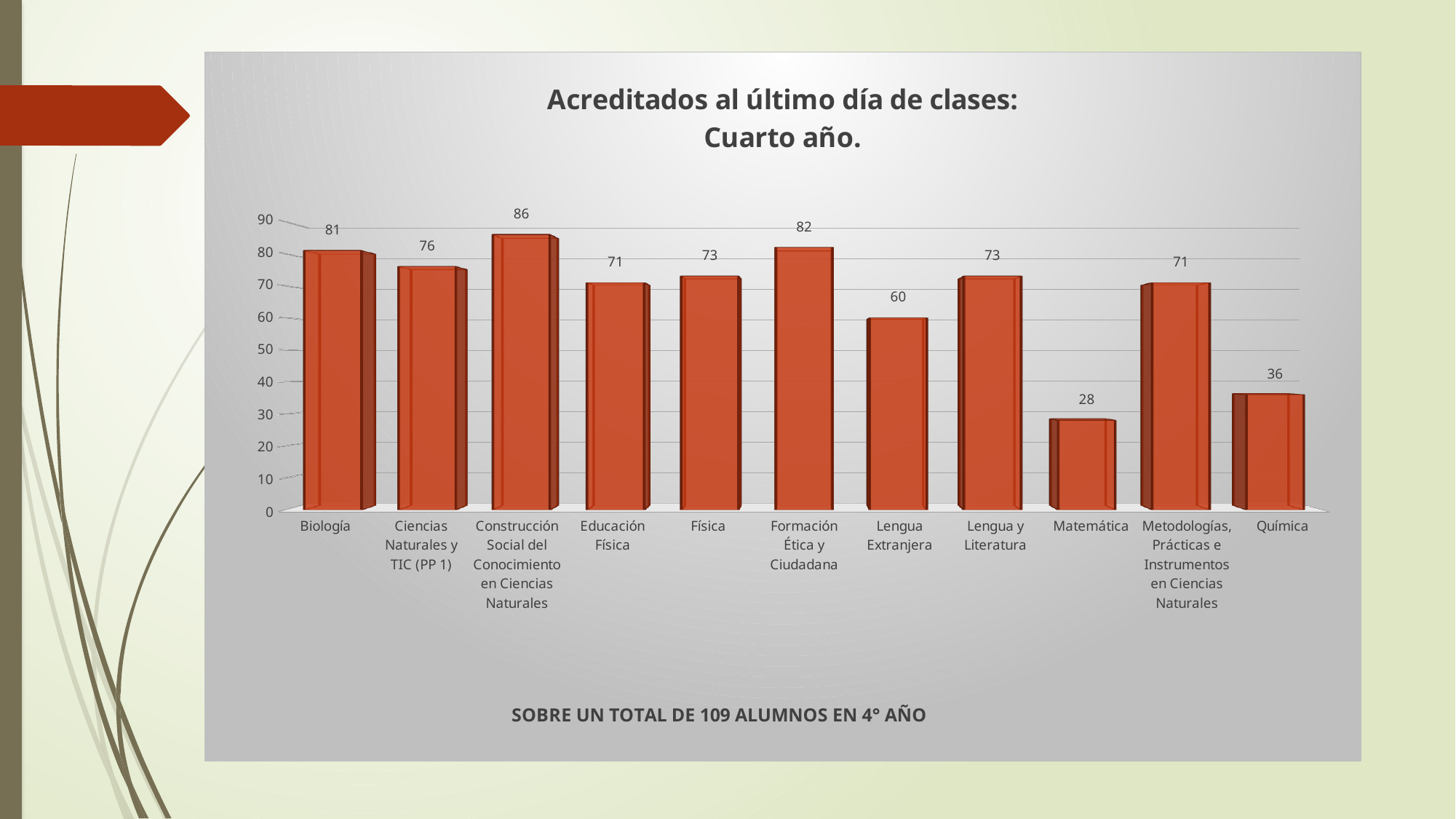
What is the value for Lengua Extranjera? 60 What is the value for Matemática? 28 According to the text below the chart, how many students are in 4° año in total? 109 How many categories are shown on the x axis? 11 What is the value for Biología? 81 Which category has the highest value? Construcción Social del Conocimiento en Ciencias Naturales Is the value for Química greater or less than 40? less What is the title of the chart? Acreditados al último día de clases: Cuarto año. Which category has the lowest value? Matemática What is the difference between the values for Formación Ética y Ciudadana and Química? 46 Which is larger, the value for Ciencias Naturales y TIC (PP 1) or the value for Física? Ciencias Naturales y TIC (PP 1) What kind of chart is shown on the slide? bar chart